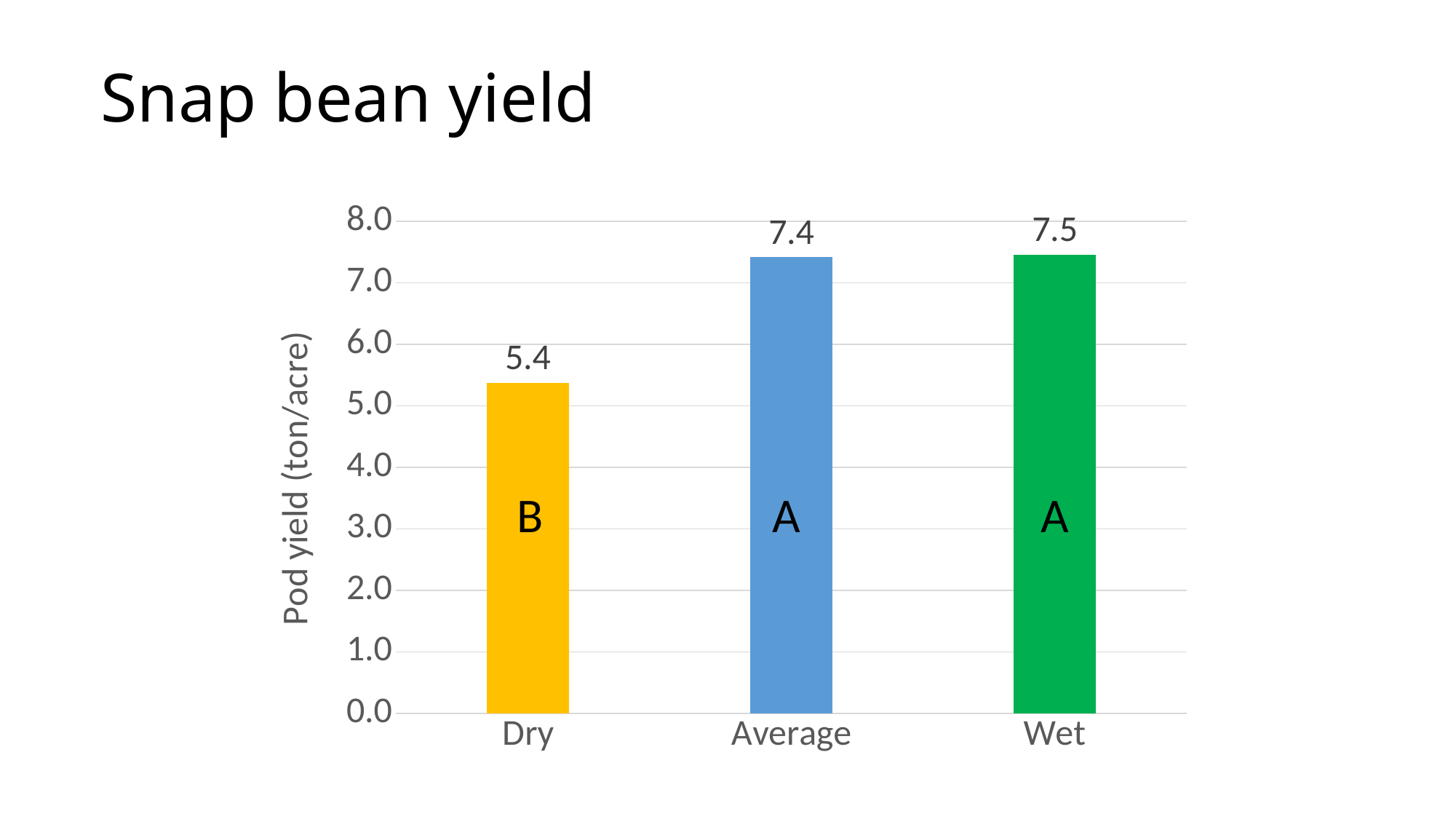
Which condition has the lowest pod yield? Dry What is the label of the y axis? Pod yield (ton/acre) How many conditions are shown on the x axis? 3 Is the pod yield for Wet greater or less than 7.0? greater What is the difference in pod yield between Wet and Dry? 2.1 What is the difference in pod yield between Average and Dry? 2.0 What kind of chart is shown on the slide? bar chart Is the pod yield for Dry greater or less than 6.0? less Which has a higher pod yield, Dry or Average? Average What is the pod yield for the Wet condition? 7.5 What is the pod yield for the Dry condition? 5.4 What is the pod yield for the Average condition? 7.4